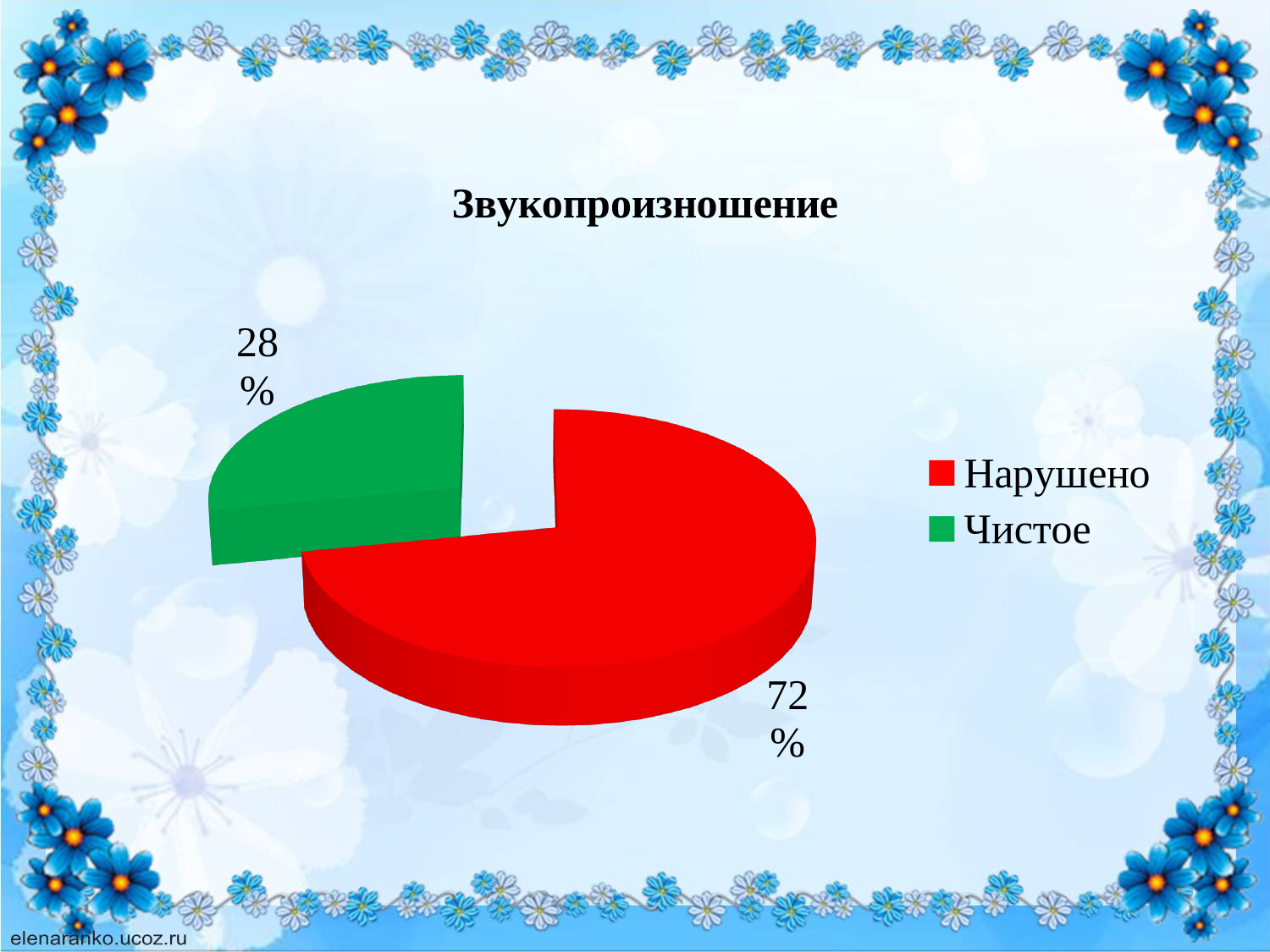
Which is larger, the value for Нарушено or the value for Чистое? Нарушено What share of the pie does the Нарушено slice represent? 72% Which category has the largest share of the pie? Нарушено How many entries does the legend list? 2 What is the value for Чистое? 28% Which category has the smallest share of the pie? Чистое How many slices does the pie chart have? 2 What is the title of the chart? Звукопроизношение What is the value for Нарушено? 72% What colour is the slice for Чистое? green What is the difference between the values for Нарушено and Чистое? 44% What kind of chart is shown on the slide? pie chart